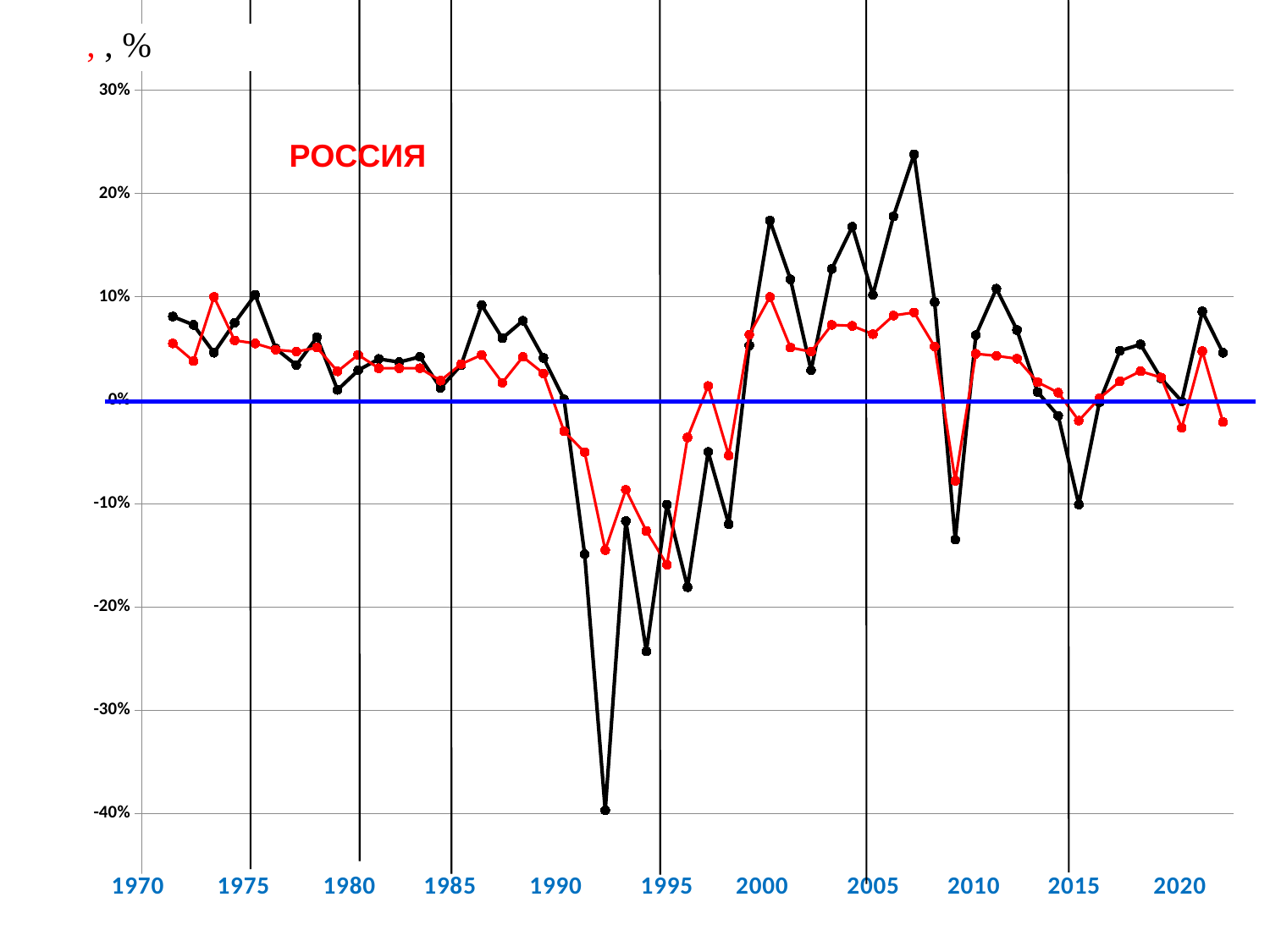
Is the value of the black line in 2007 greater or less than 20%? greater Is the value of the black line in 1992 greater or less than -30%? less What kind of chart is shown on the slide? line chart Does the black line rise or fall between 2005 and 2007? rise How many lines (data series) are plotted on the chart? 2 Is the value of the red line in 1995 greater or less than -10%? less In 1992, which line is higher, the black line or the red line? red line What red text label is written inside the chart area? РОССИЯ In 2007, which line is higher, the black line or the red line? black line Which line reaches the lowest value anywhere on the chart, the black line or the red line? black line